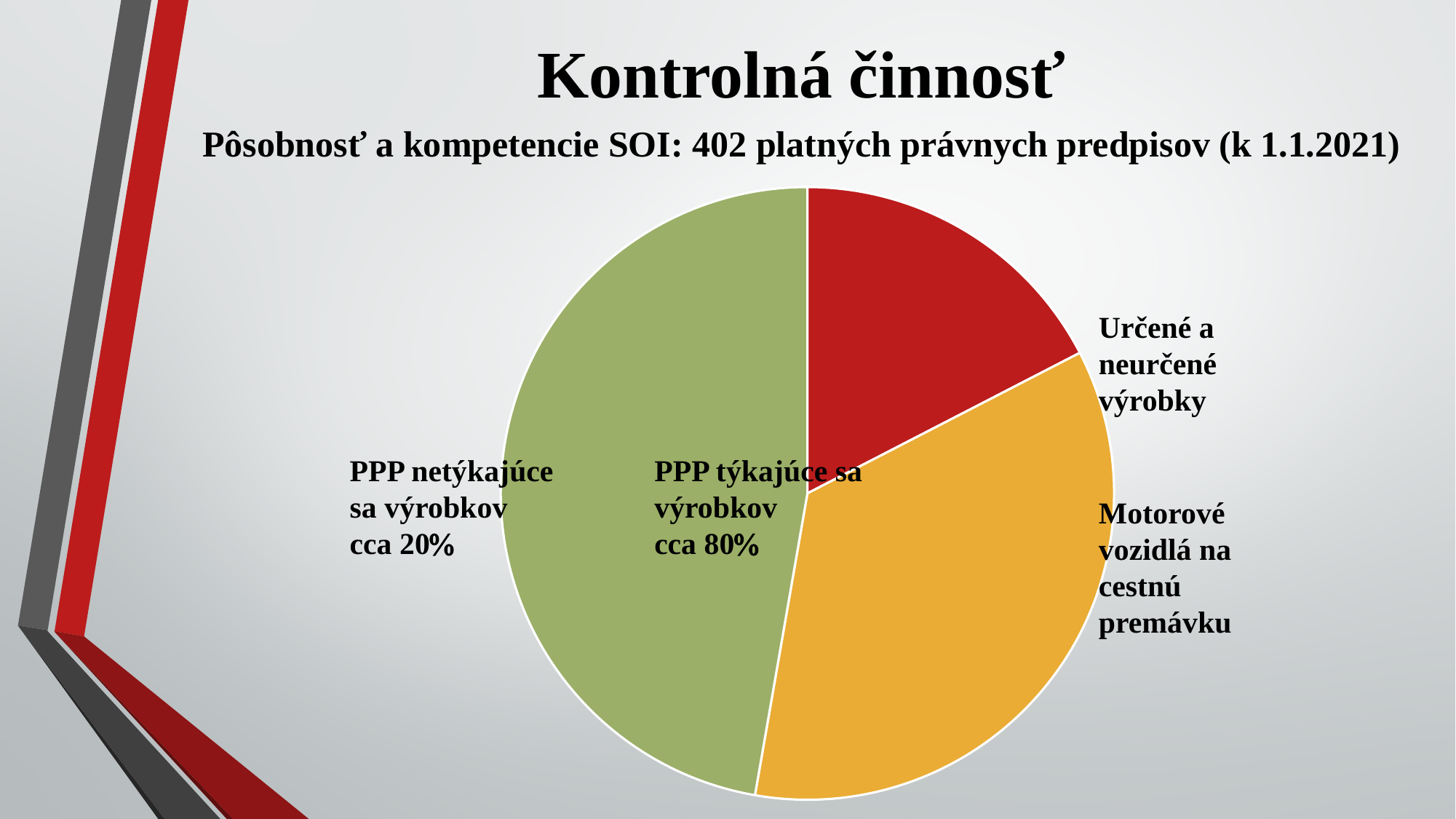
Which label is placed next to the red slice of the pie chart? Určené a neurčené výrobky Which slice is larger, the green slice or the orange slice? the green slice What is the title of the slide containing the pie chart? Kontrolná činnosť Which slice is larger, the orange slice or the red slice? the orange slice How many slices does the pie chart have? 3 Which slice of the pie chart is the largest? the green slice What kind of chart is shown on the slide? pie chart Which slice of the pie chart is the smallest? the red slice